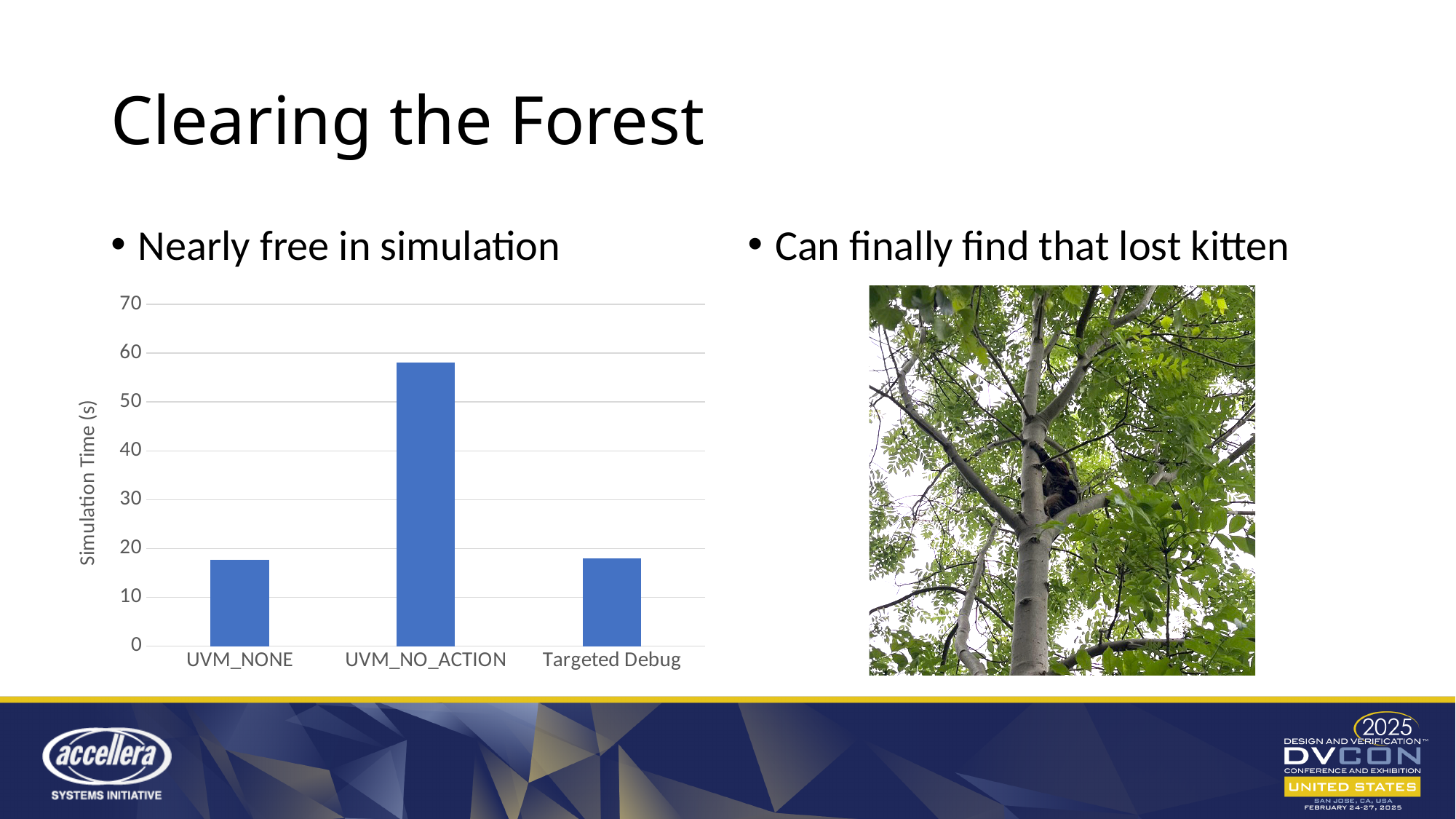
Which is larger, the value for UVM_NONE or the value for UVM_NO_ACTION? UVM_NO_ACTION How many categories are shown on the x axis of the chart? 3 Which is larger, the value for UVM_NO_ACTION or the value for Targeted Debug? UVM_NO_ACTION What kind of chart is shown on the slide? bar chart Is the value for UVM_NO_ACTION greater or less than 50? greater Is the value for UVM_NO_ACTION greater or less than 60? less Is the value for UVM_NONE greater or less than 20? less Which category has the highest simulation time in the chart? UVM_NO_ACTION What is the highest value shown on the y axis of the chart? 70 What is the label on the y axis of the chart? Simulation Time (s)